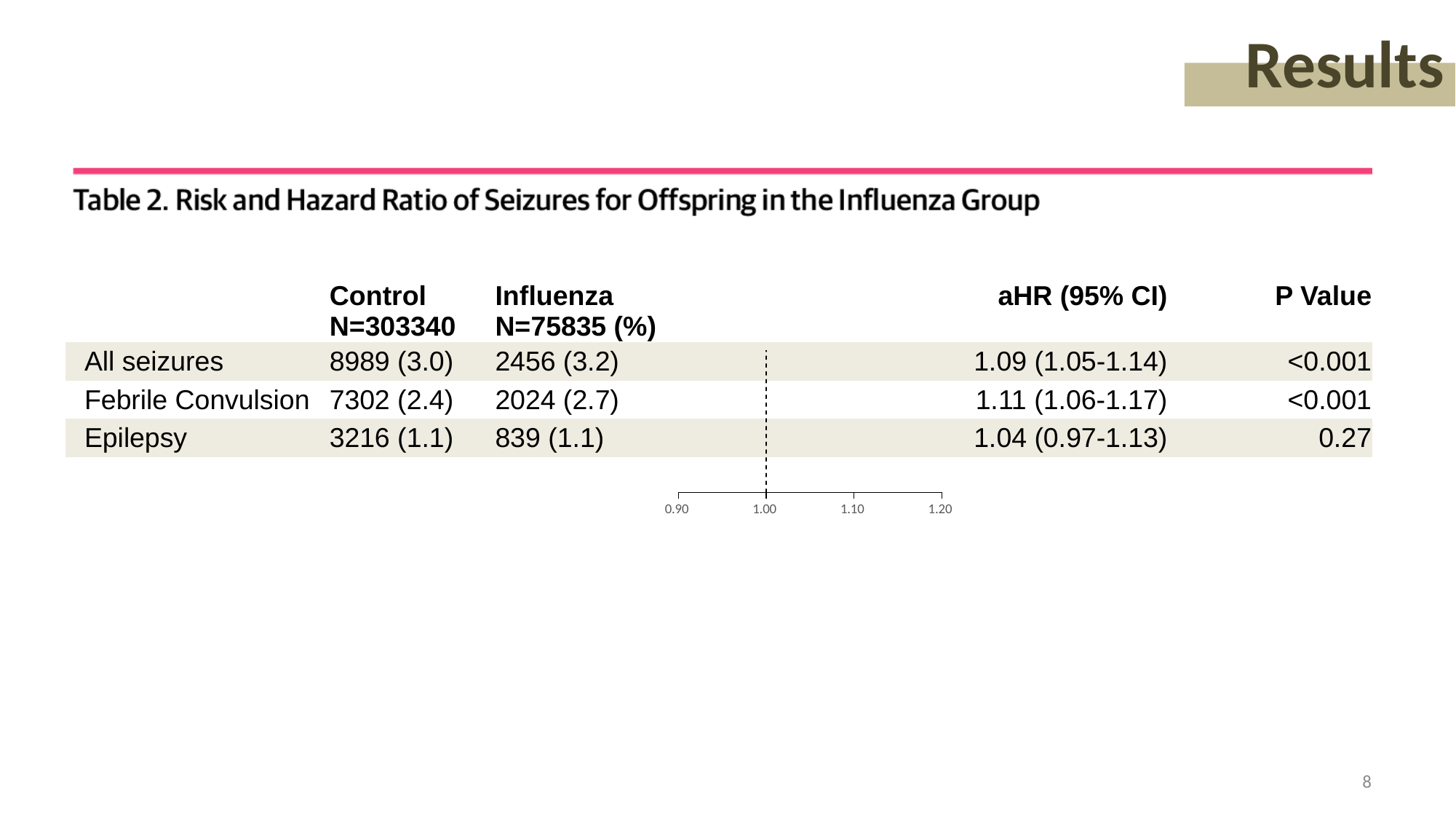
Is the aHR for Febrile Convulsion greater or less than 1.00? greater What is the aHR (95% CI) for Febrile Convulsion? 1.11 (1.06-1.17) What value does the dashed vertical reference line on the forest plot axis mark? 1.00 Which outcome has the highest adjusted hazard ratio? Febrile Convulsion Which outcome has the lowest adjusted hazard ratio? Epilepsy How many seizure outcomes are listed in the table? 3 What is the aHR (95% CI) for Epilepsy? 1.04 (0.97-1.13) How many offspring in the Influenza group had Febrile Convulsion? 2024 (2.7) What is the adjusted hazard ratio (aHR) for All seizures in the Influenza group? 1.09 (1.05-1.14) What are the minimum and maximum tick values shown on the forest plot axis? 0.90 and 1.20 What is the P value for Epilepsy? 0.27 How many offspring in the Control group had Epilepsy? 3216 (1.1)